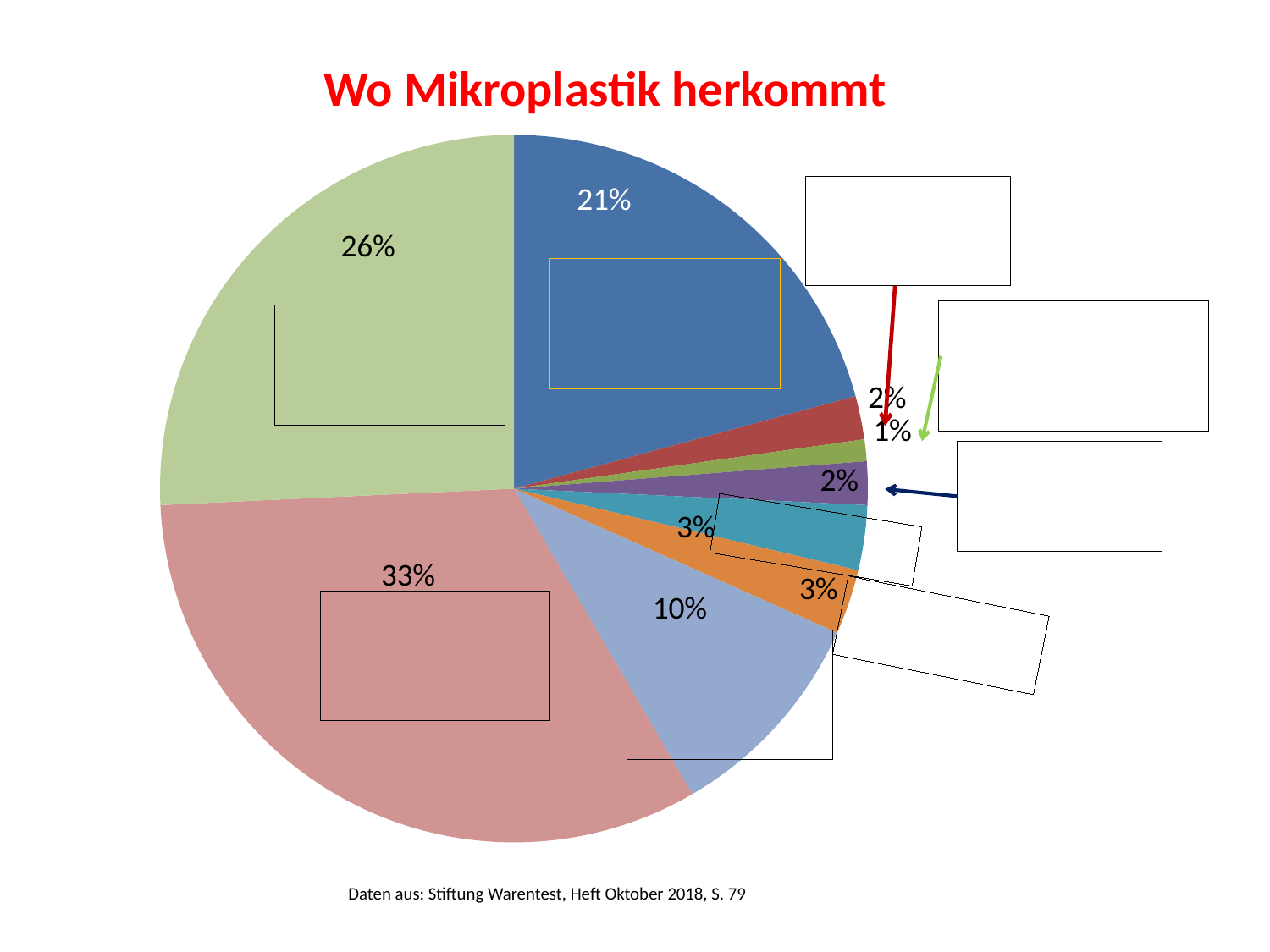
What percentage is shown on the light green slice at the top left of the pie? 26% What is the smallest share shown in the pie chart? 1% What is the title of the chart? Wo Mikroplastik herkommt What percentage is shown on the large pink slice at the bottom of the pie? 33% According to the note at the bottom of the slide, where do the data come from? Stiftung Warentest, Heft Oktober 2018, S. 79 What percentage is shown on the dark blue slice at the top right of the pie? 21% How many slices does the pie chart have? 9 What is the largest share shown in the pie chart? 33% Which slice is larger, the dark blue slice (21%) or the light green slice (26%)? the light green slice What percentage is shown on the light blue slice at the bottom right of the pie? 10% What is the difference in percentage points between the pink slice (33%) and the light green slice (26%)? 7 What kind of chart is shown on the slide? pie chart